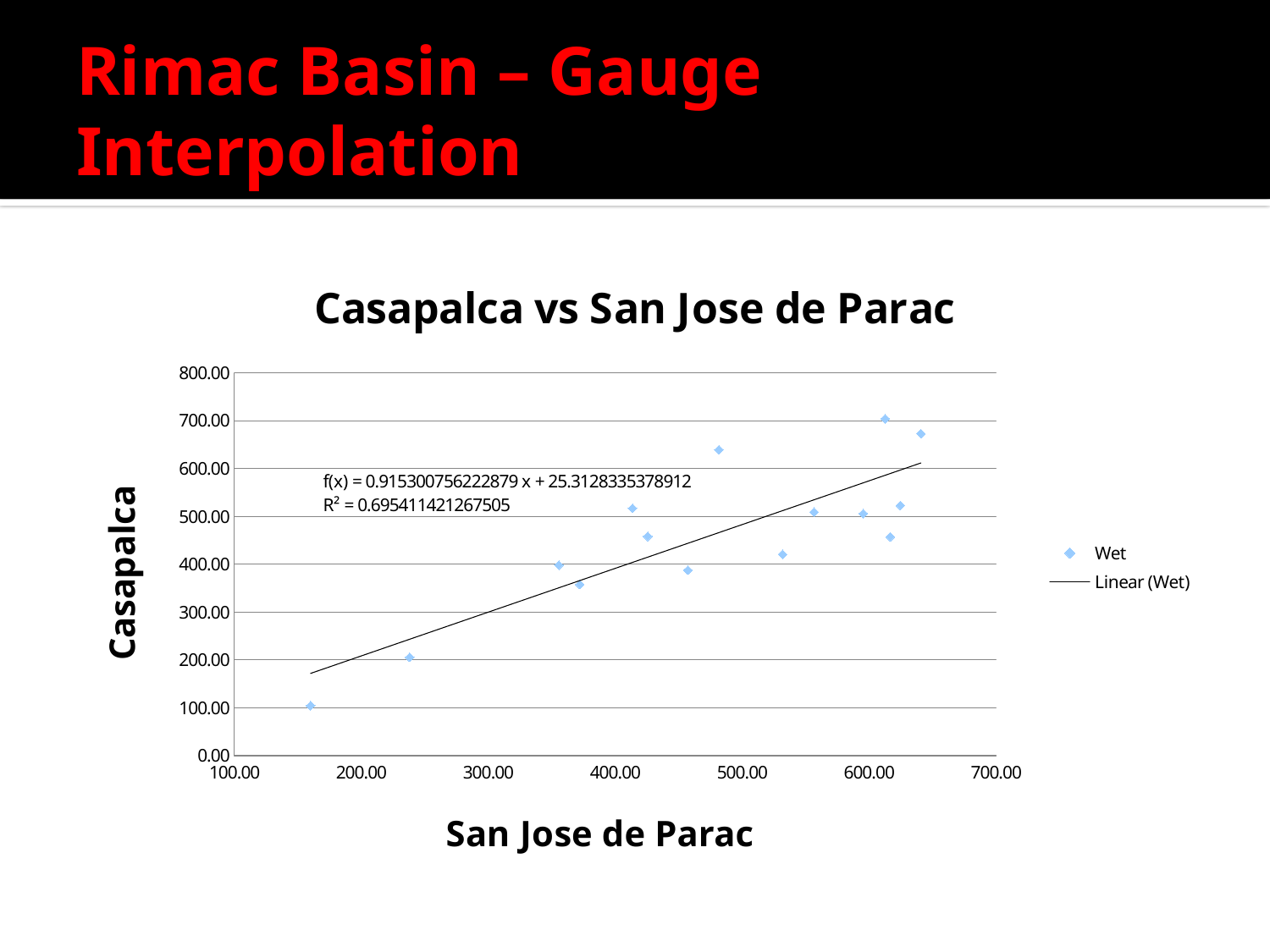
What kind of chart is shown on the slide? Scatter chart How many data points are plotted in the Wet series? 15 What is the slope of the fitted line f(x) printed on the chart? 0.915300756222879 How many entries does the chart legend list? 2 What is the R² value printed on the chart? 0.695411421267505 What is the intercept of the fitted line f(x) printed on the chart? 25.3128335378912 Is the Casapalca value of the leftmost data point (near San Jose de Parac = 160) greater or less than 200? less What is the label of the x axis? San Jose de Parac Do the Casapalca values generally rise or fall as San Jose de Parac increases? Rise Is the Casapalca value of the data point near San Jose de Parac = 370 greater or less than 400? less What is the title of the chart? Casapalca vs San Jose de Parac Is the Casapalca value of the data point near San Jose de Parac = 480 greater or less than 600? greater